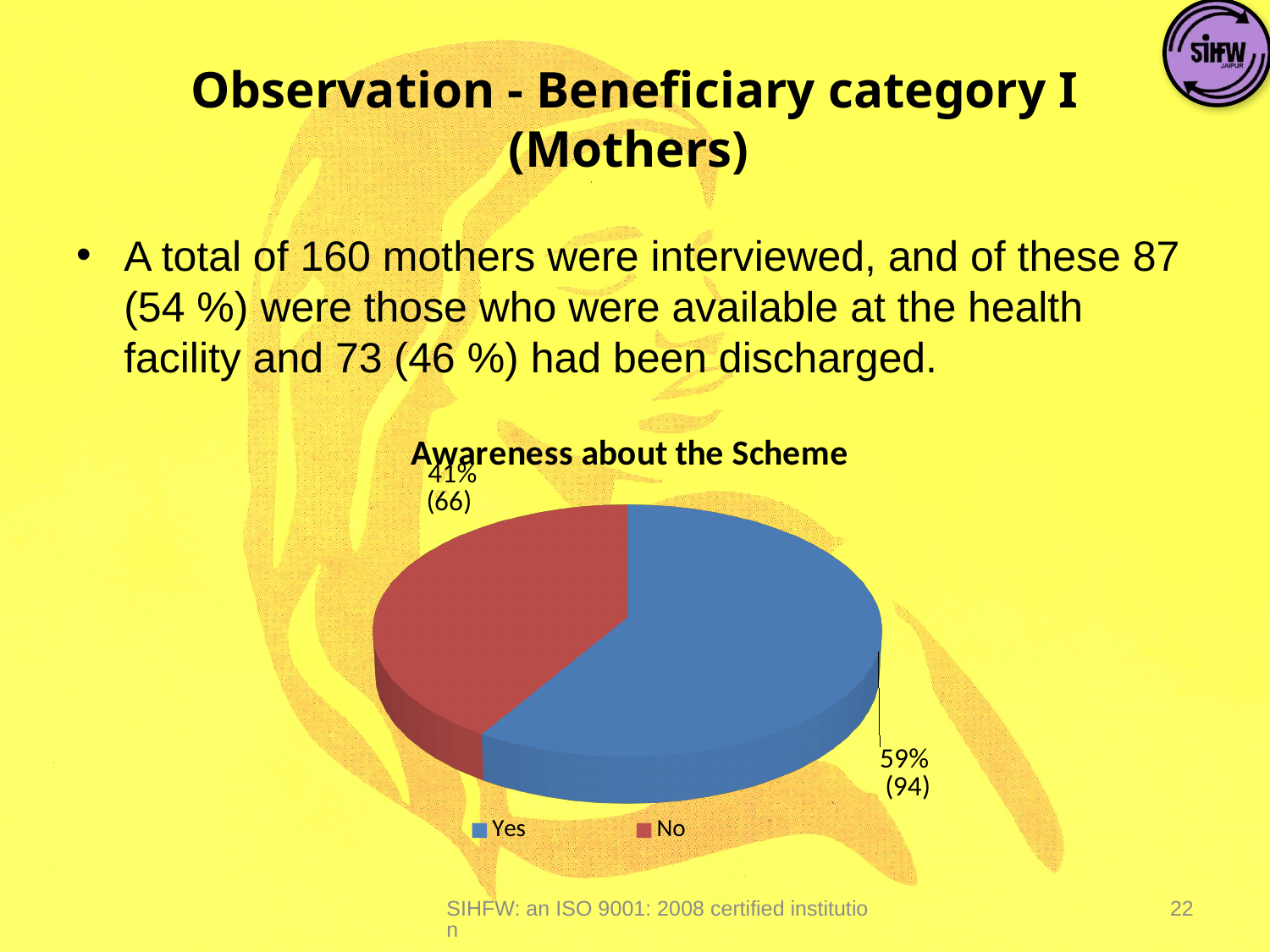
What kind of chart is shown on the slide? pie chart What percentage of the pie is labelled "No"? 41% What percentage of the pie is labelled "Yes"? 59% What is the difference in percentage points between the "Yes" and "No" slices? 18 What count is shown in parentheses for the "Yes" slice? 94 Which slice of the pie is the smallest? No How many categories does the legend of the pie chart list? 2 Which slice of the pie is the largest? Yes Which is larger, the "Yes" slice or the "No" slice? Yes What count is shown in parentheses for the "No" slice? 66 What colour is the "No" slice in the pie chart? red What is the title of the pie chart? Awareness about the Scheme